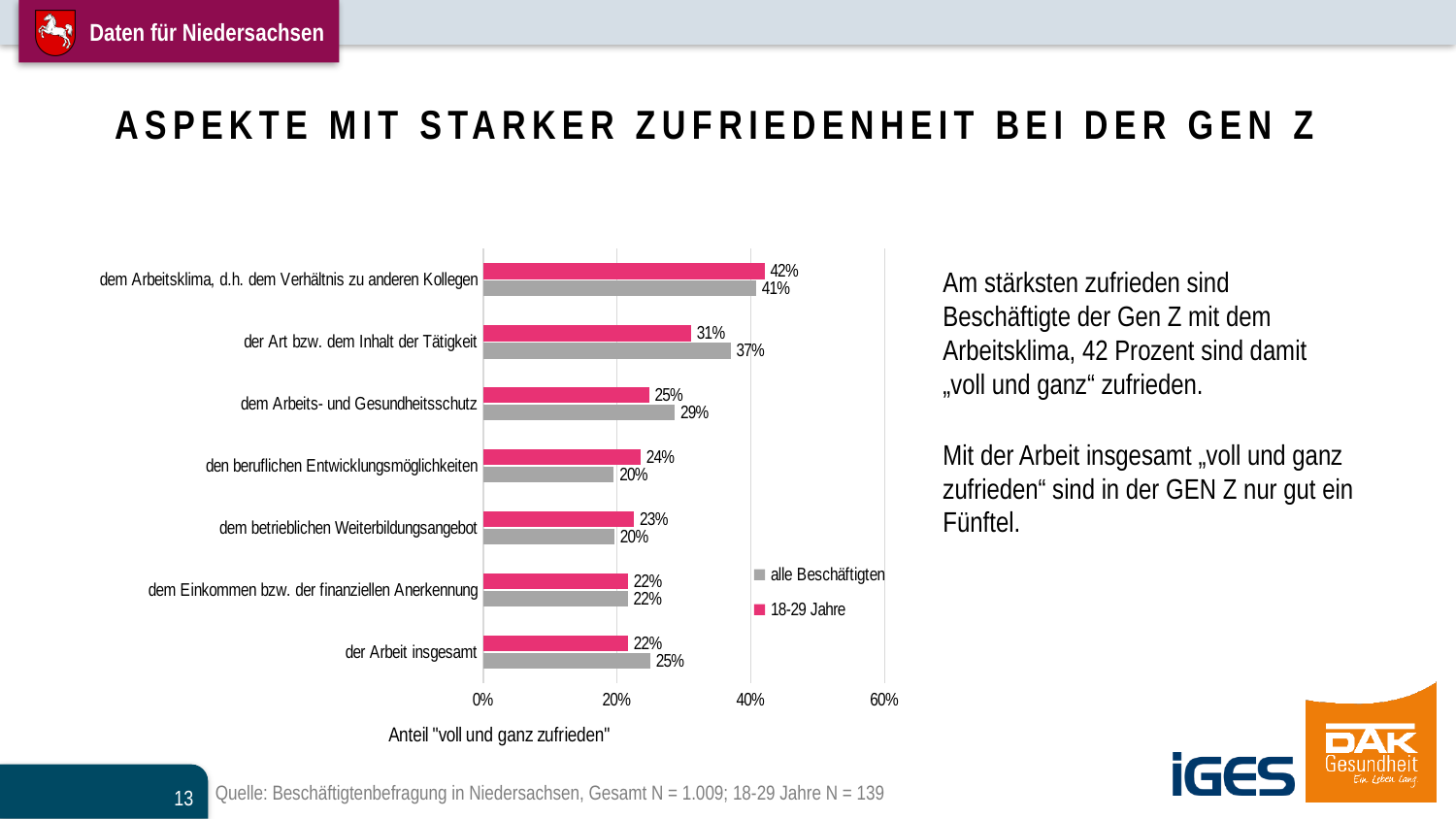
What is the value for "18-29 Jahre" for "dem Arbeitsklima, d.h. dem Verhältnis zu anderen Kollegen"? 42% Which category has the highest value for "18-29 Jahre"? dem Arbeitsklima, d.h. dem Verhältnis zu anderen Kollegen How many series does the legend list? 2 What is the value for "alle Beschäftigten" for "der Art bzw. dem Inhalt der Tätigkeit"? 37% Is the value for "18-29 Jahre" for "dem Arbeitsklima, d.h. dem Verhältnis zu anderen Kollegen" greater or less than 40%? greater What is the difference between "alle Beschäftigten" and "18-29 Jahre" for "der Art bzw. dem Inhalt der Tätigkeit"? 6% How many categories are shown on the chart? 7 What is the value for "alle Beschäftigten" for "der Arbeit insgesamt"? 25% Which category has the lowest value for "alle Beschäftigten"? den beruflichen Entwicklungsmöglichkeiten and dem betrieblichen Weiterbildungsangebot (both 20%) For "dem Arbeits- und Gesundheitsschutz", which series has the larger value, "18-29 Jahre" or "alle Beschäftigten"? alle Beschäftigten What kind of chart is shown on the slide? bar chart What is the x-axis title of the chart? Anteil "voll und ganz zufrieden"